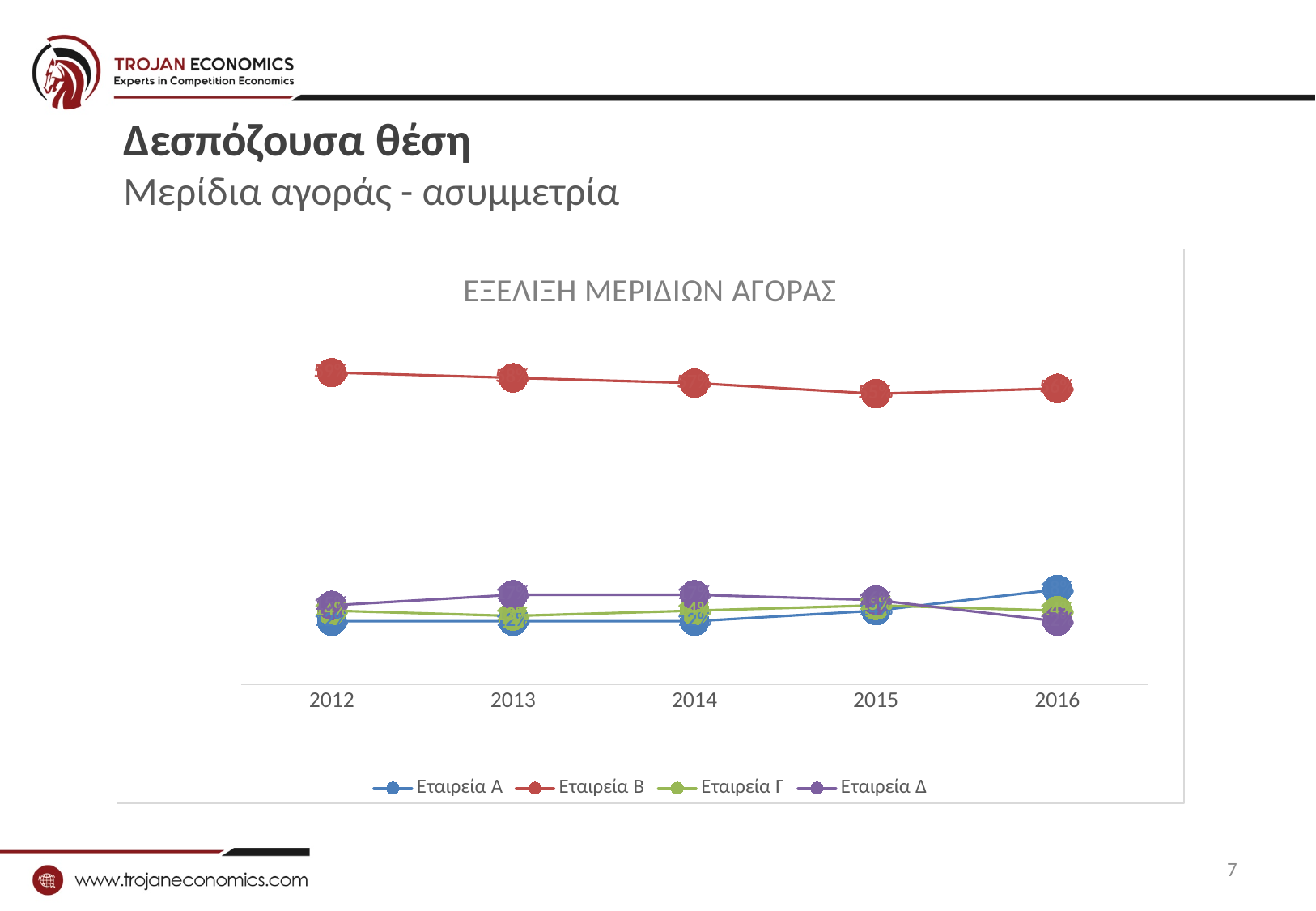
In 2012, which is larger: Εταιρεία Β or Εταιρεία Γ? Εταιρεία Β Which series has the highest values across all years? Εταιρεία Β In 2016, which is larger: Εταιρεία Α or Εταιρεία Δ? Εταιρεία Α How many years are shown on the x axis? 5 In 2013, which is larger: Εταιρεία Δ or Εταιρεία Α? Εταιρεία Δ How many series does the legend list? 4 What kind of chart is shown on the slide? line chart Does the line for Εταιρεία Β rise or fall from 2012 to 2016? fall What colour is the line for Εταιρεία Β? red Which series has the lowest value in 2016? Εταιρεία Δ Does the line for Εταιρεία Α rise or fall from 2012 to 2016? rise What is the title of the chart? ΕΞΕΛΙΞΗ ΜΕΡΙΔΙΩΝ ΑΓΟΡΑΣ